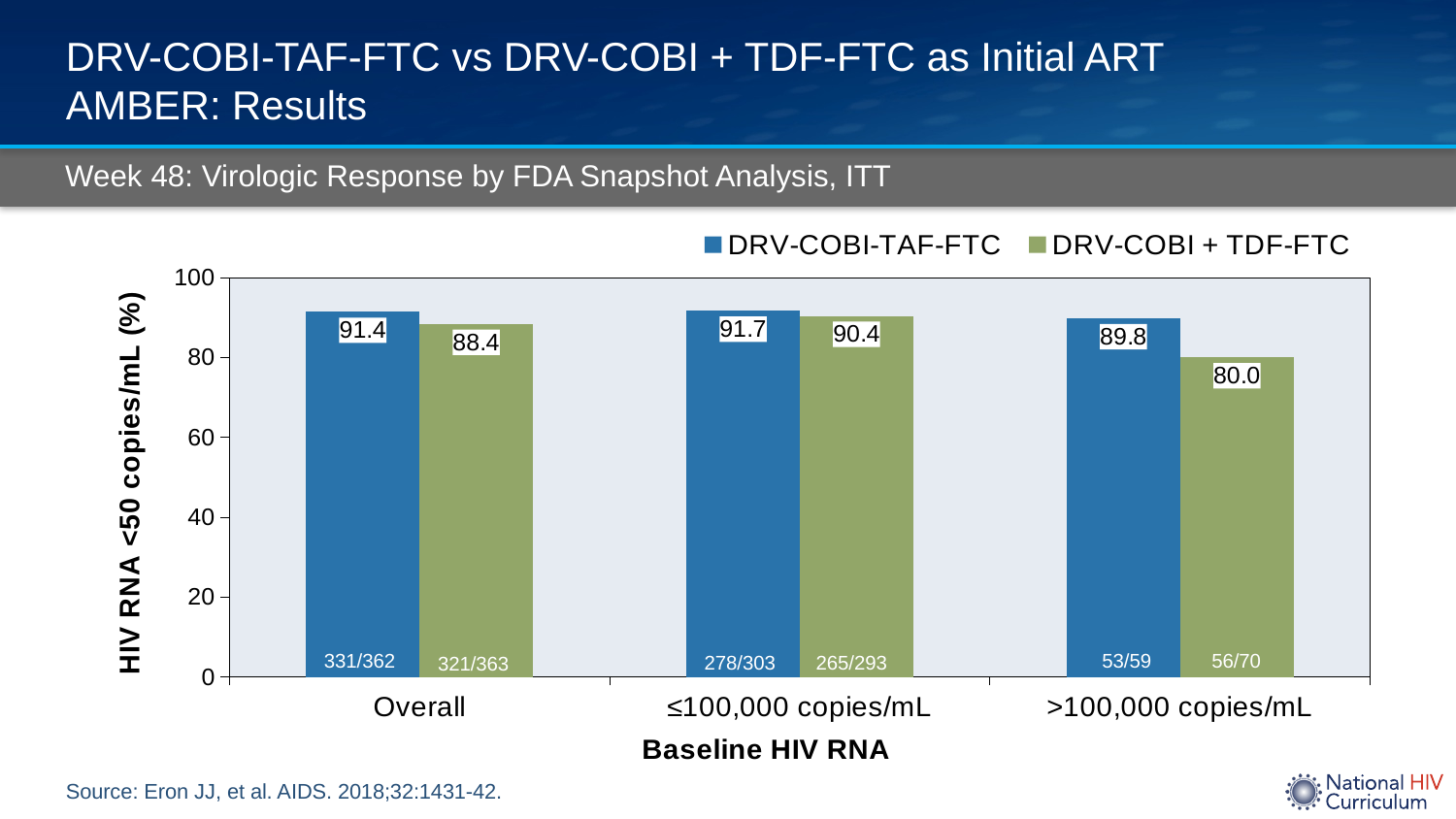
In the ≤100,000 copies/mL category, which series has the larger value? DRV-COBI-TAF-FTC What is the difference between DRV-COBI-TAF-FTC and DRV-COBI + TDF-FTC in the >100,000 copies/mL category? 9.8 What is the difference between DRV-COBI-TAF-FTC and DRV-COBI + TDF-FTC in the Overall category? 3.0 What kind of chart is shown on the slide? Bar chart What is the value for DRV-COBI-TAF-FTC in the Overall category? 91.4 What is the value for DRV-COBI + TDF-FTC in the >100,000 copies/mL category? 80.0 How many baseline HIV RNA categories are shown on the x axis? 3 What fraction is shown at the base of the DRV-COBI-TAF-FTC bar in the >100,000 copies/mL category? 53/59 How many series does the legend list? 2 Which category has the highest value for DRV-COBI-TAF-FTC? ≤100,000 copies/mL Which baseline HIV RNA category has the lowest value for DRV-COBI + TDF-FTC? >100,000 copies/mL What is the value for DRV-COBI + TDF-FTC in the ≤100,000 copies/mL category? 90.4